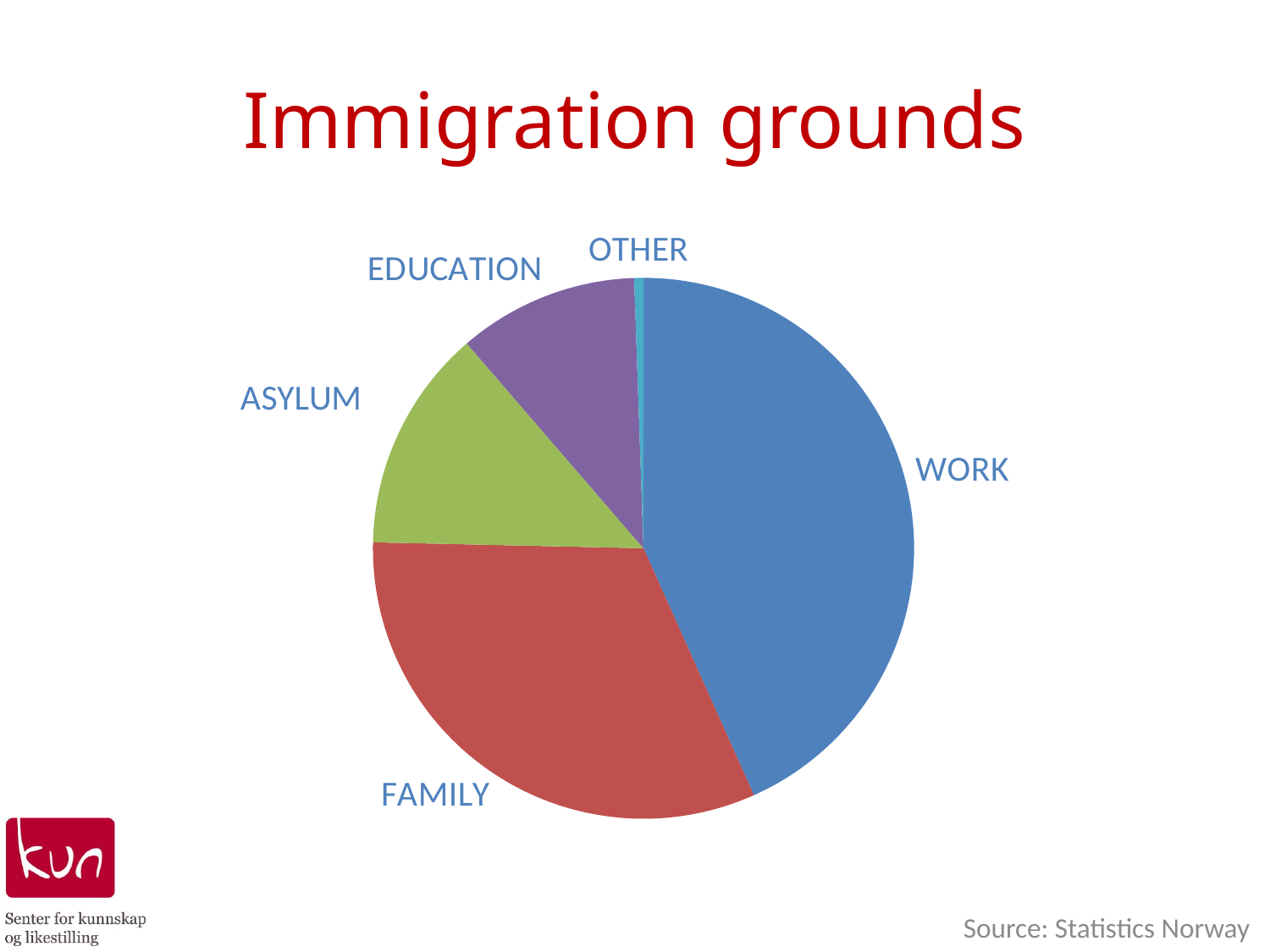
What is the title of the slide containing the pie chart? Immigration grounds Which slice is larger, EDUCATION or OTHER? EDUCATION What kind of chart is shown on the slide? pie chart Which immigration ground has the largest slice of the pie? WORK Which slice is larger, FAMILY or ASYLUM? FAMILY Which slice is larger, WORK or FAMILY? WORK What colour is the FAMILY slice of the pie chart? red Which immigration ground has the smallest slice of the pie? OTHER Which immigration ground has the second-largest slice of the pie? FAMILY How many categories (slices) does the pie chart have? 5